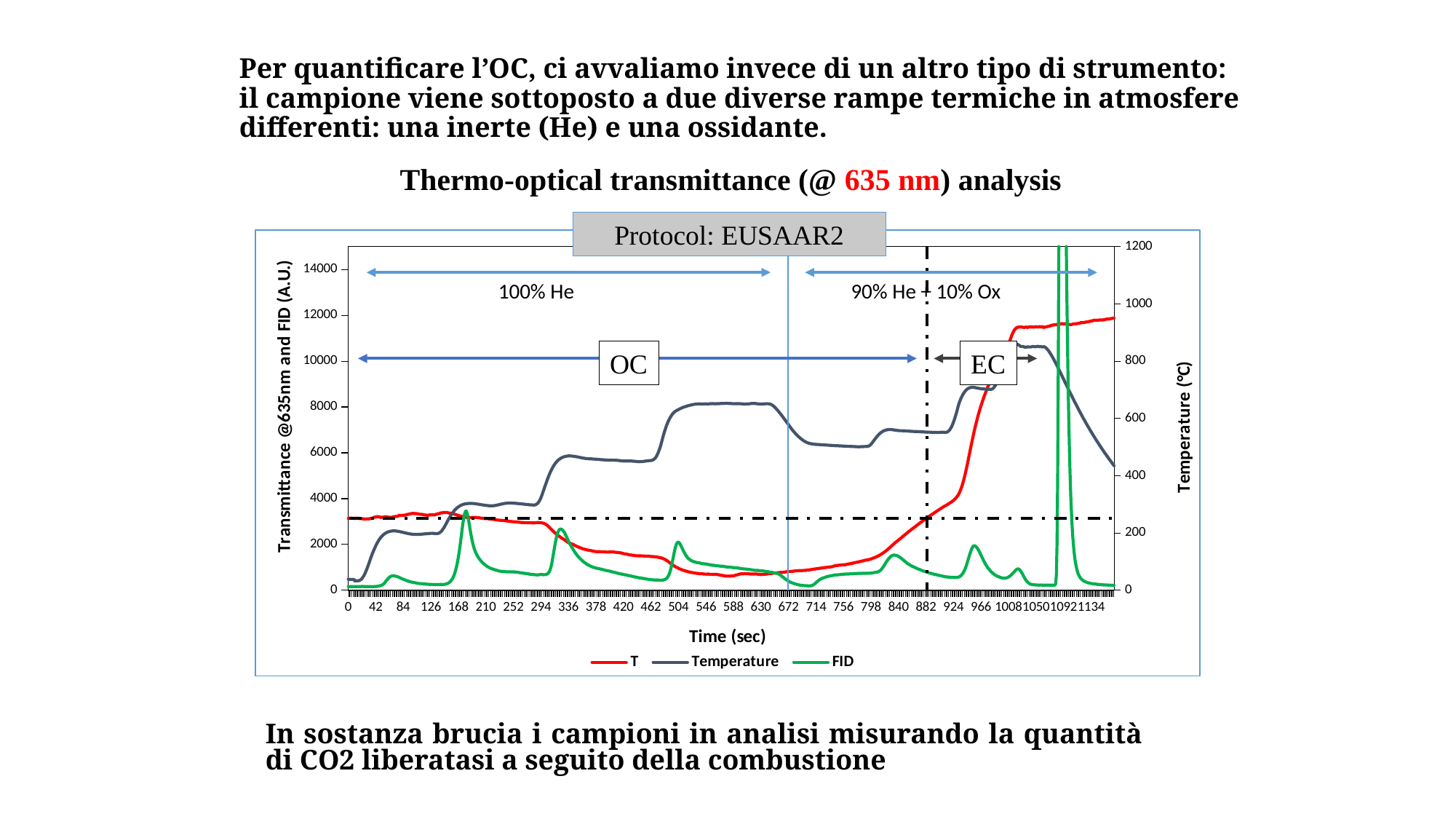
Is the value of the T series at time 0 greater or less than 4000 on the left axis? less Is the value of the T series at time 672 greater or less than 2000 on the left axis? less What are the three series named in the chart legend? T, Temperature, FID Is the value of the FID series at time 630 greater or less than 2000 on the left axis? less How many series does the chart legend list? 3 Does the Temperature series rise or fall between time 1050 and time 1134? fall At time 1134, which series has the higher value on the chart, T or FID? T Does the T series rise or fall between time 882 and time 1134? rise What kind of chart is shown on the slide? line chart What is the title of the x axis of the chart? Time (sec) Does the T series rise or fall between time 168 and time 630? fall